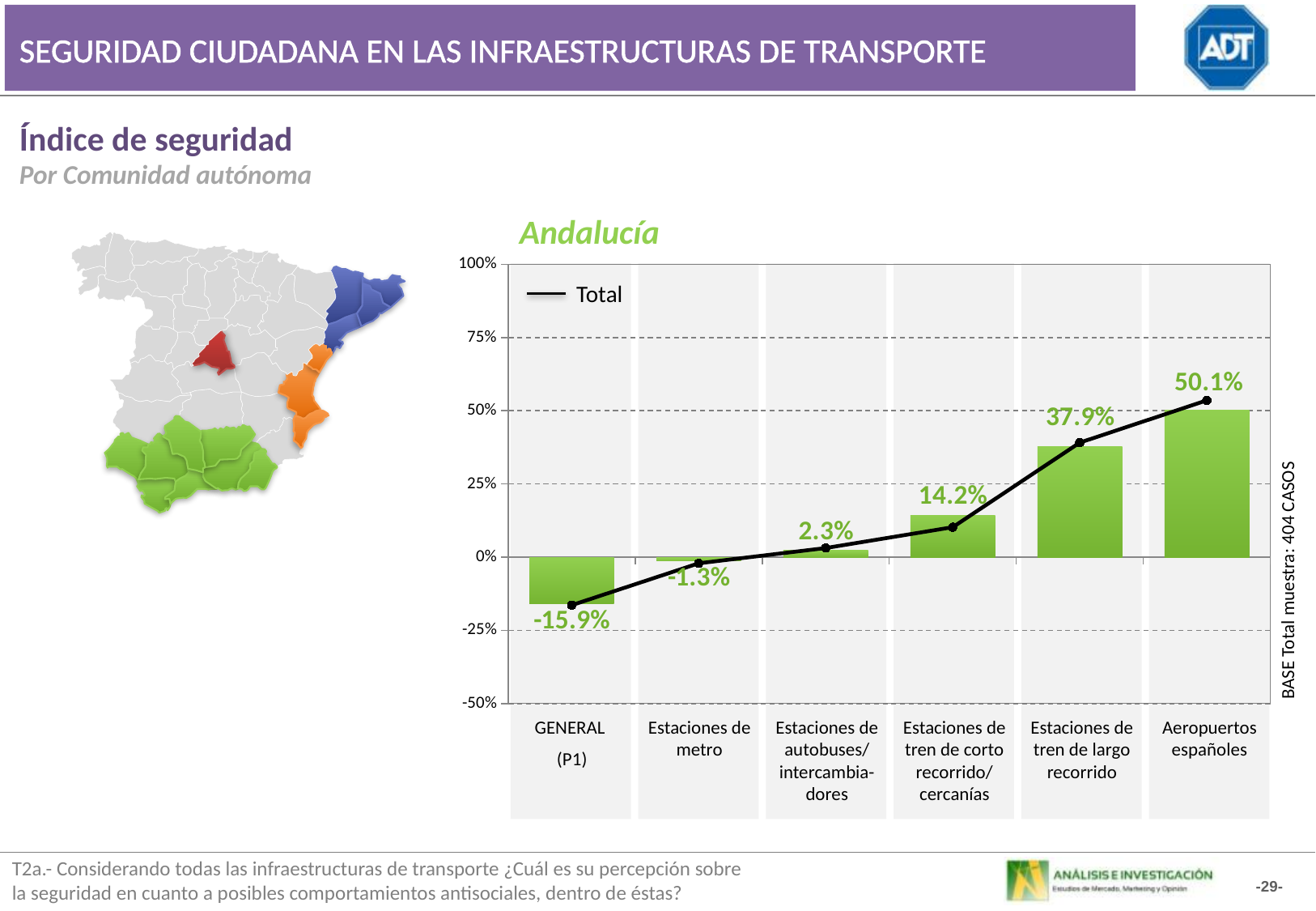
How many categories are shown on the x axis of the Andalucía chart? 6 What series does the legend of the Andalucía chart list? Total Which is larger in the Andalucía chart: Estaciones de autobuses/intercambiadores or Estaciones de tren de corto recorrido/cercanías? Estaciones de tren de corto recorrido/cercanías What is the value for GENERAL (P1) in the Andalucía chart? -15.9% Do the bar values in the Andalucía chart rise or fall from left to right along the x axis? rise Which category has the lowest value in the Andalucía chart? GENERAL (P1) What is the difference between the values for Aeropuertos españoles and Estaciones de tren de largo recorrido in the Andalucía chart? 12.2% What is the value for Aeropuertos españoles in the Andalucía chart? 50.1% Which category has the highest value in the Andalucía chart? Aeropuertos españoles What is the title of the chart on the slide? Andalucía What is the value for Estaciones de tren de largo recorrido in the Andalucía chart? 37.9% What is the value for Estaciones de metro in the Andalucía chart? -1.3%